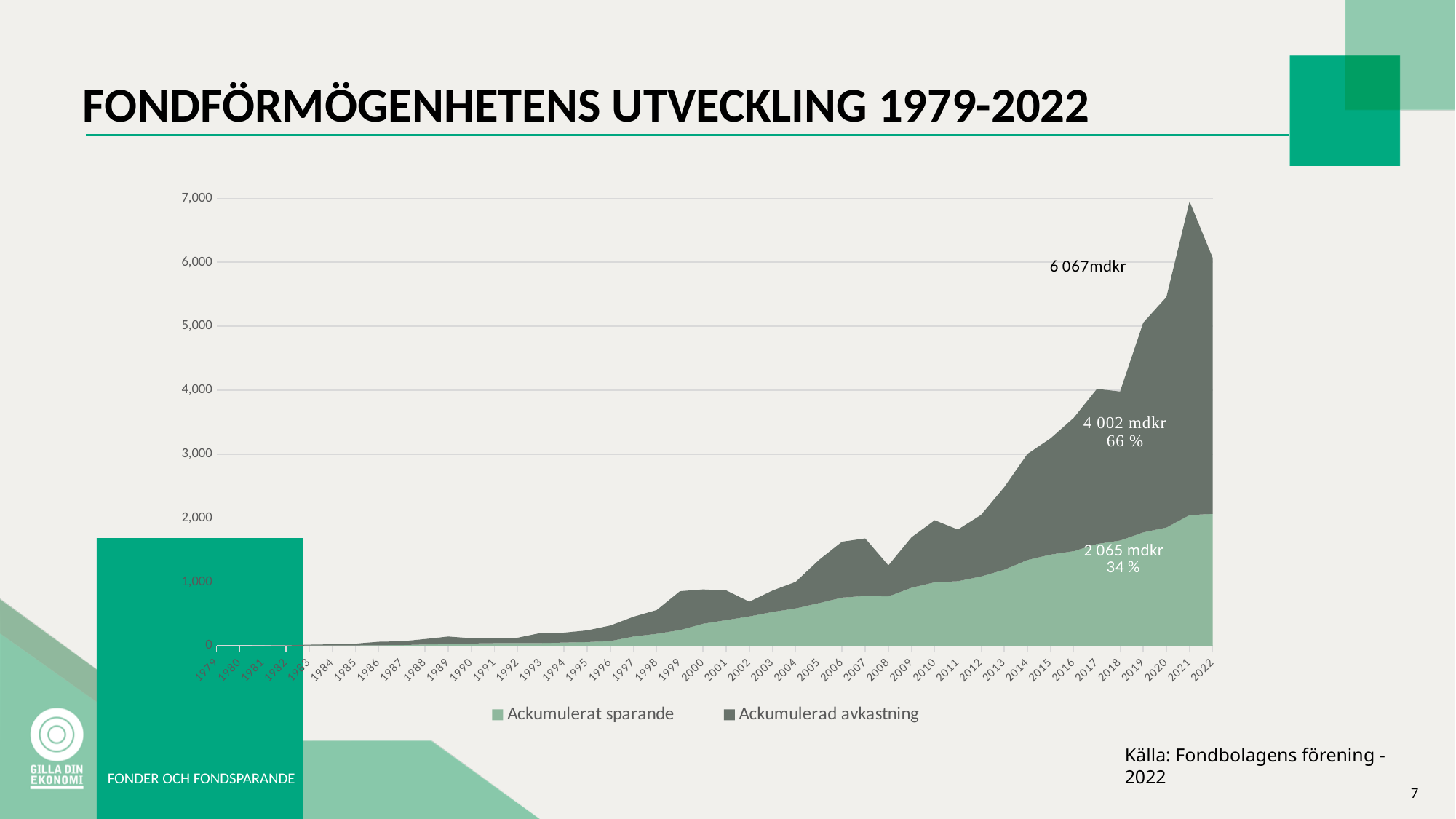
What is the labelled value for Ackumulerat sparande in 2022? 2 065 mdkr What kind of chart is shown on the slide? Area chart What is the labelled value for Ackumulerad avkastning in 2022? 4 002 mdkr How many years are shown on the x axis? 44 Is the total value in 2021 greater or less than 6,000? greater What are the two series named in the legend? Ackumulerat sparande and Ackumulerad avkastning In 2022, which is larger: Ackumulerat sparande or Ackumulerad avkastning? Ackumulerad avkastning What share of the 2022 total does Ackumulerad avkastning make up, according to the label? 66 % What is the labelled total fund wealth in 2022? 6 067 mdkr What is the difference between Ackumulerad avkastning and Ackumulerat sparande in 2022? 1 937 mdkr What share of the 2022 total does Ackumulerat sparande make up, according to the label? 34 % How many series does the legend list? 2